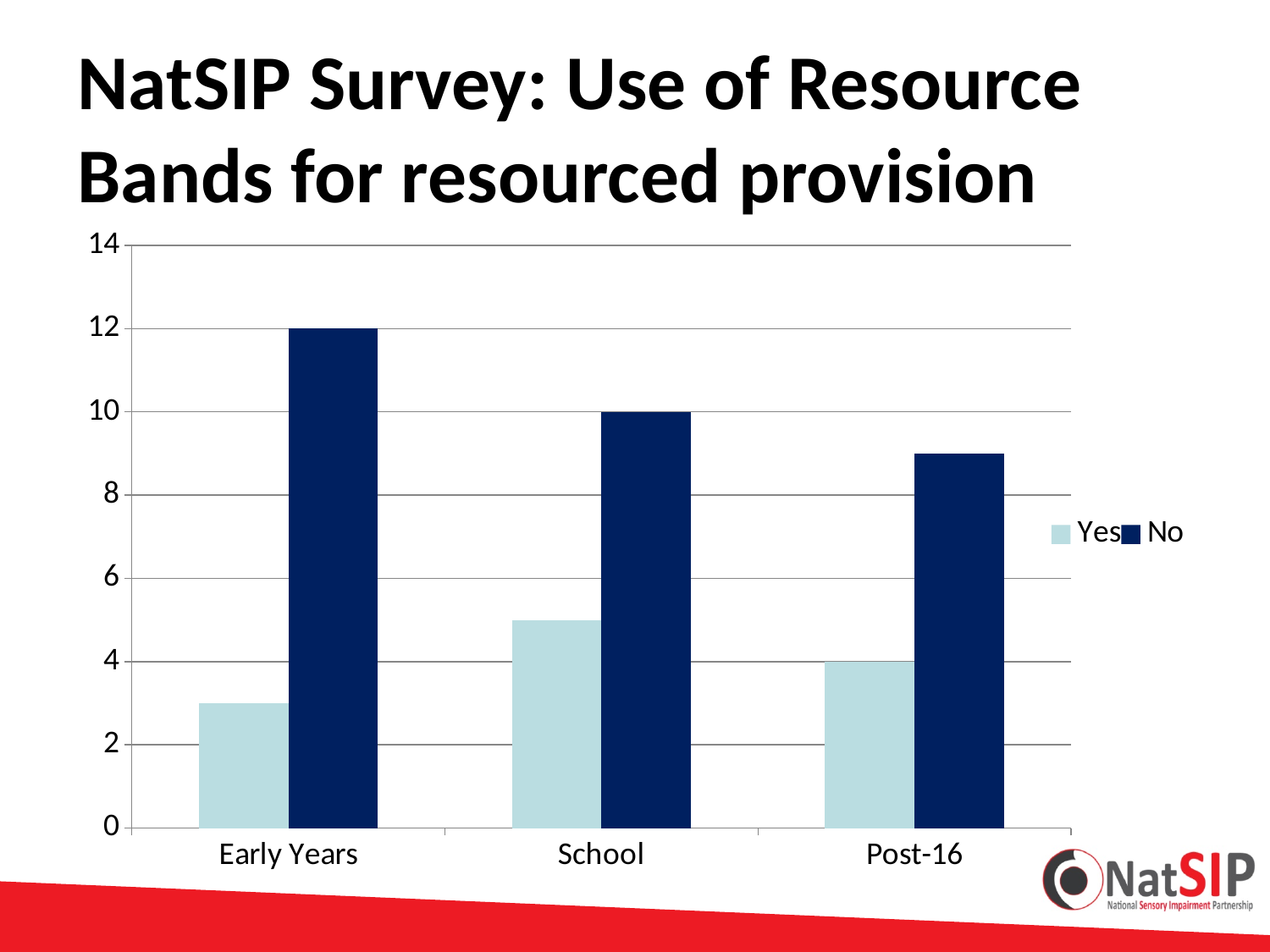
Which category has the highest value for the No series? Early Years How many categories are shown on the x axis? 3 What is the value of the No series for School? 10 Is the Yes value for School greater or less than 4? greater What type of chart is shown on the slide? bar chart Which category has the lowest value for the Yes series? Early Years What is the difference between the No values for Early Years and School? 2 Is the No value for Post-16 greater or less than 10? less What is the value of the Yes series for Post-16? 4 How many series does the legend list? 2 Do the No values rise or fall from Early Years to Post-16? fall What is the value of the No series for Early Years? 12